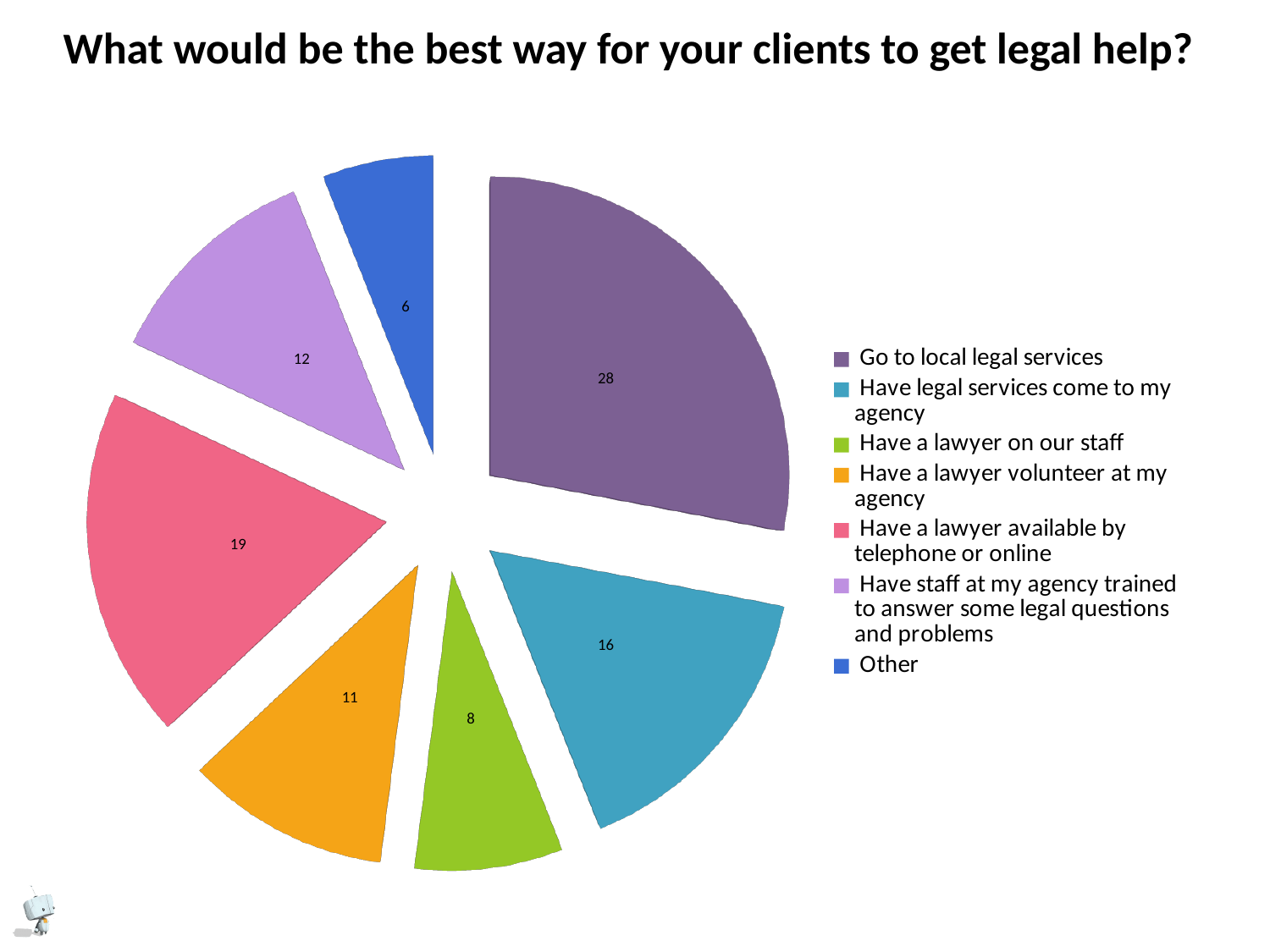
What is the difference between the values for "Go to local legal services" and "Have legal services come to my agency"? 12 What is the value for "Go to local legal services"? 28 What is the title of the slide? What would be the best way for your clients to get legal help? What is the value for "Have a lawyer available by telephone or online"? 19 Which is larger: "Have a lawyer volunteer at my agency" or "Have staff at my agency trained to answer some legal questions and problems"? Have staff at my agency trained to answer some legal questions and problems What is the value for "Other"? 6 Which category has the largest slice? Go to local legal services What share of the pie does "Have a lawyer available by telephone or online" represent? 19% What is the value for "Have a lawyer on our staff"? 8 How many categories does the pie chart have? 7 Which category has the smallest slice? Other What kind of chart is shown on the slide? Pie chart